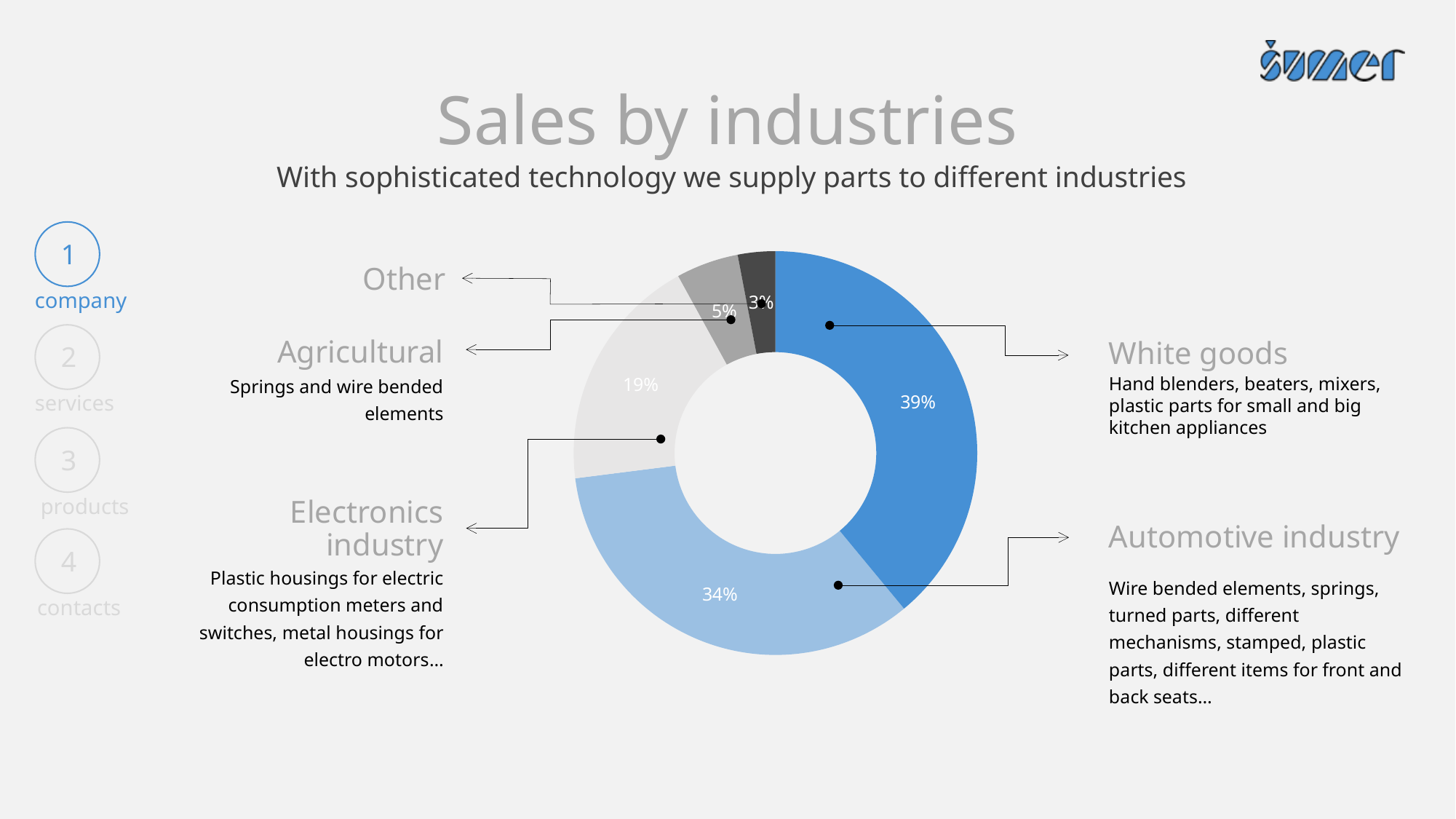
What share of sales does Agricultural account for? 5% How many industry segments does the chart show? 5 Which industry has the smallest share of sales? Other Which has a larger share of sales, the Electronics industry or Agricultural? Electronics industry What is the difference in percentage points between the Electronics industry and Agricultural? 14 What share of sales does the Electronics industry account for? 19% What share of sales does White goods account for? 39% What is the difference in percentage points between White goods and the Automotive industry? 5 What kind of chart is shown on the slide? Donut (pie) chart What share of sales does the Automotive industry account for? 34% What is the title of the slide containing the chart? Sales by industries Which industry has the largest share of sales? White goods